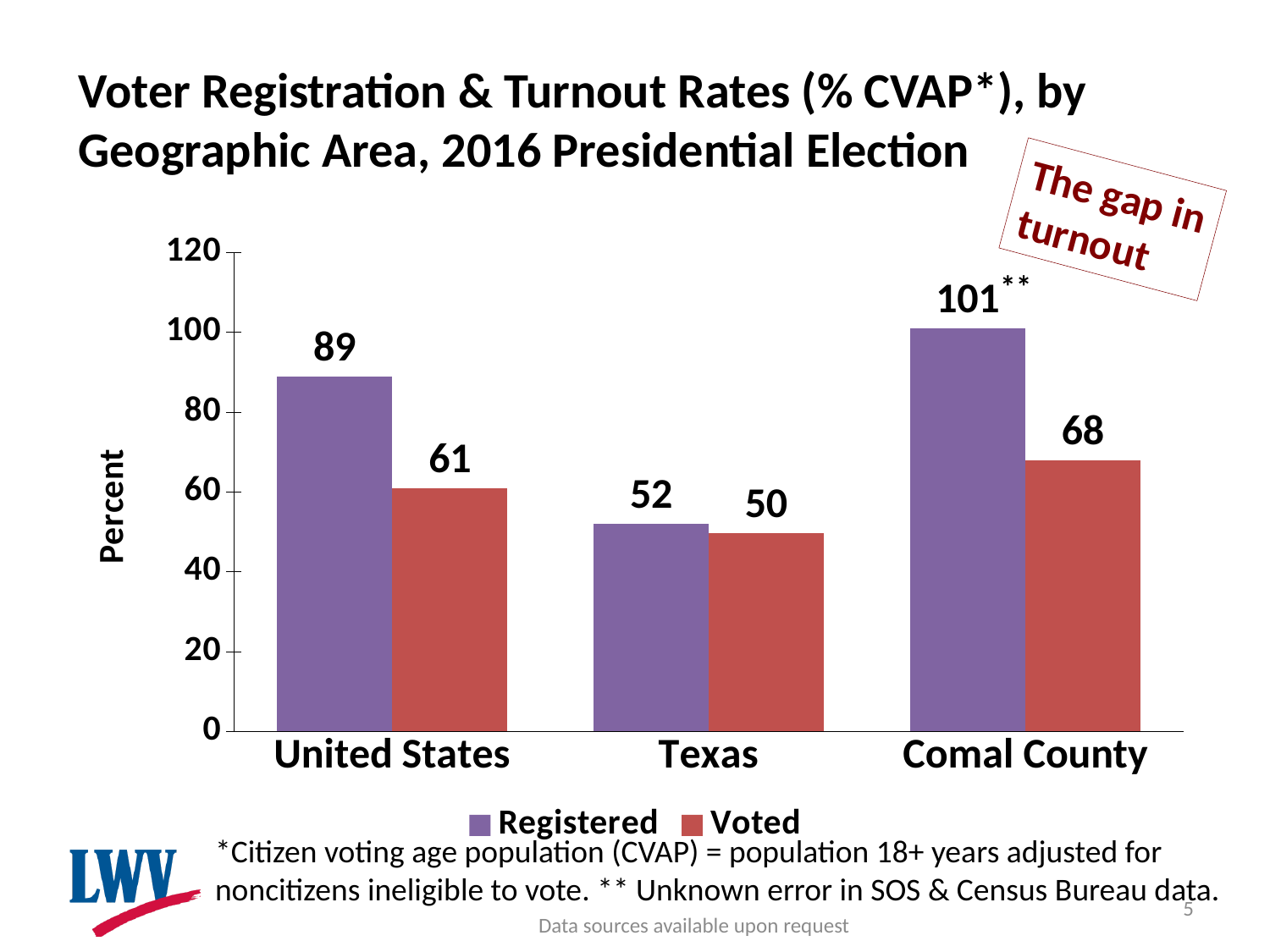
What is the Registered value for the United States? 89 What is the Registered value for Comal County? 101 How many series does the legend list? 2 Is the Registered value for Texas greater or less than 60? less Which geographic area has the highest Voted value? Comal County What is the Voted value for Texas? 50 What is the label on the vertical axis? Percent Which is larger, the Voted value for the United States or the Voted value for Comal County? Comal County How many geographic areas are shown on the x axis? 3 What kind of chart is shown on the slide? bar chart Which geographic area has the lowest Registered value? Texas What is the difference between the Registered and Voted values for the United States? 28